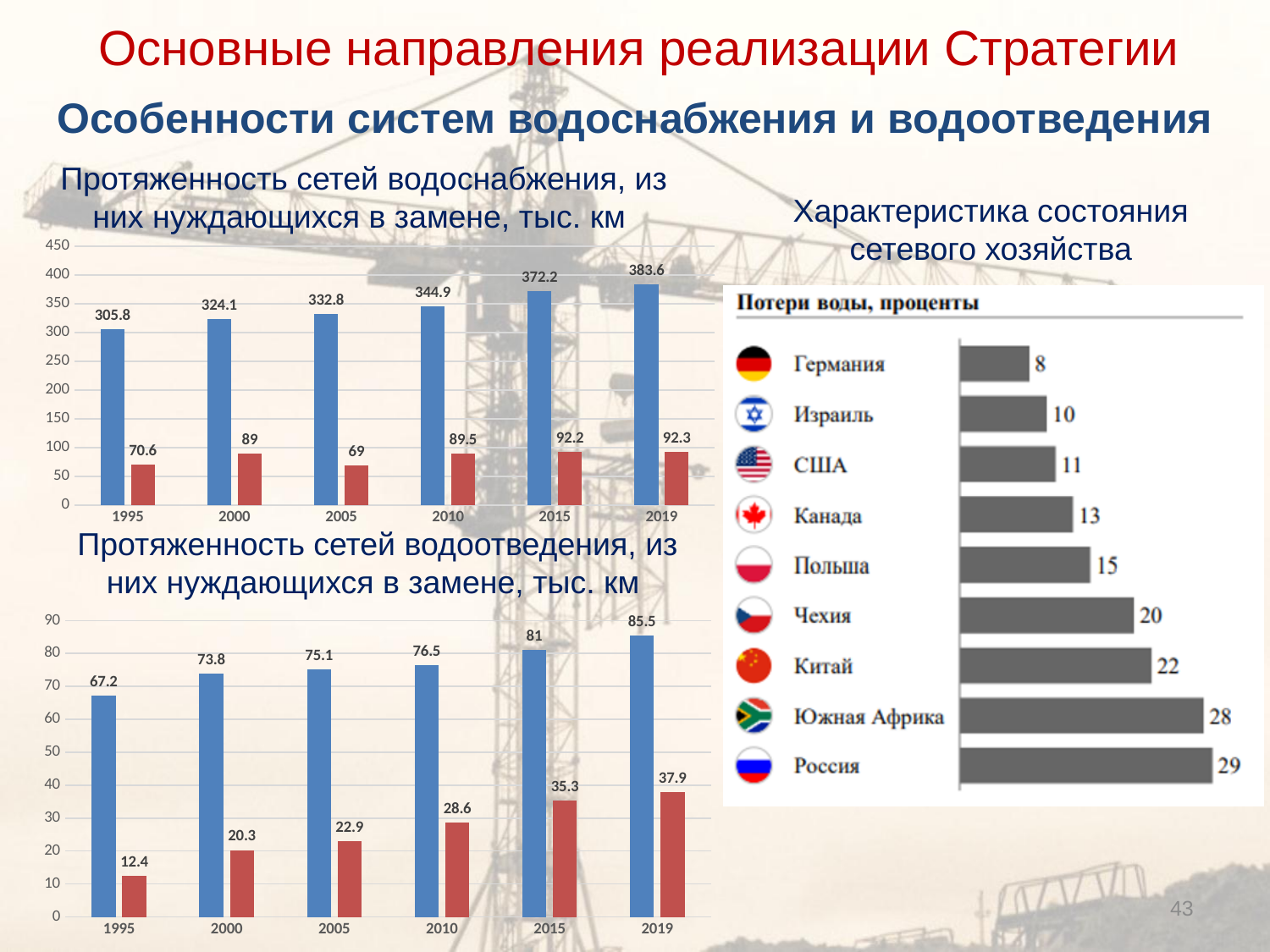
In the chart 'Протяженность сетей водоотведения, из них нуждающихся в замене, тыс. км', what is the value of the red bar for 2010? 28.6 In the chart 'Протяженность сетей водоснабжения, из них нуждающихся в замене, тыс. км', what is the value of the blue bar for 2019? 383.6 In the chart 'Потери воды, проценты', what is the value for Канада? 13 In the chart 'Потери воды, проценты', how many countries are listed? 9 In the chart 'Протяженность сетей водоснабжения, из них нуждающихся в замене, тыс. км', do the blue bars rise or fall from 1995 to 2019? rise In the chart 'Протяженность сетей водоснабжения, из них нуждающихся в замене, тыс. км', what is the difference between the blue bar and the red bar for 1995? 235.2 In the chart 'Протяженность сетей водоотведения, из них нуждающихся в замене, тыс. км', which year has the lowest red bar? 1995 In the chart 'Протяженность сетей водоотведения, из них нуждающихся в замене, тыс. км', what is the difference between the red bars for 2019 and 2015? 2.6 What kind of chart is 'Потери воды, проценты'? bar chart In the chart 'Протяженность сетей водоснабжения, из них нуждающихся в замене, тыс. км', what is the value of the red bar for 2005? 69 In the chart 'Потери воды, проценты', which country has the highest value? Россия In the chart 'Протяженность сетей водоотведения, из них нуждающихся в замене, тыс. км', how many years are shown on the x axis? 6